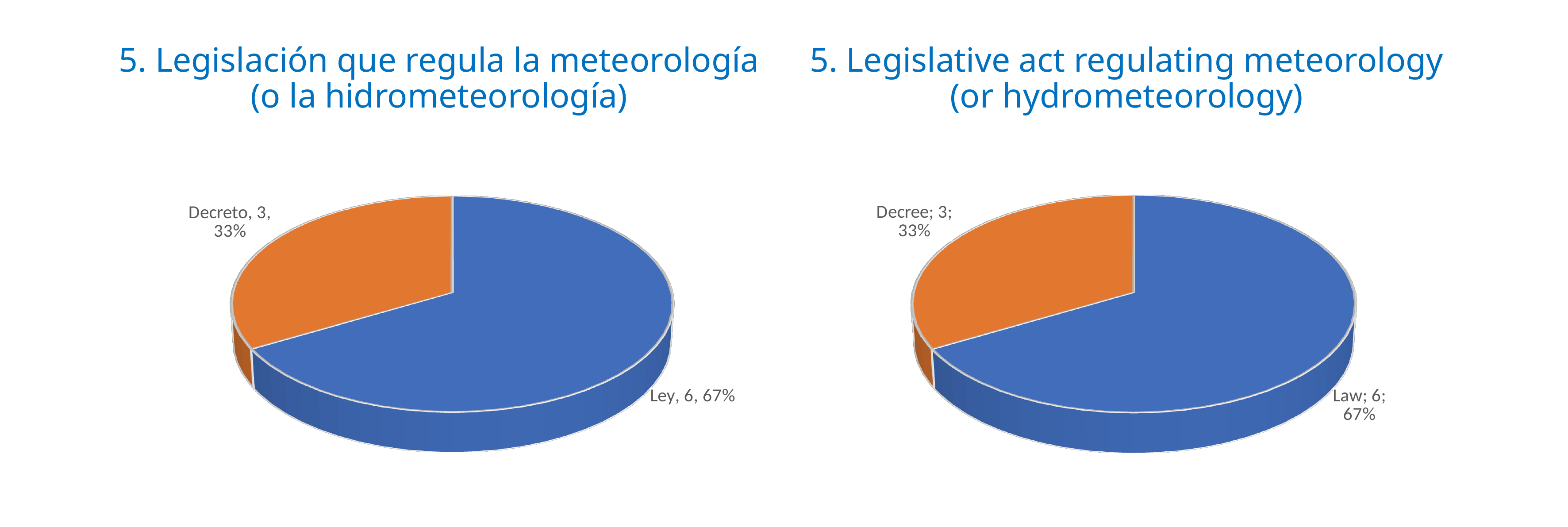
In the left chart titled '5. Legislación que regula la meteorología (o la hidrometeorología)', what share of the pie does Decreto represent? 33% In the right chart titled '5. Legislative act regulating meteorology (or hydrometeorology)', what is the difference between the values for Law and Decree? 3 In the right chart titled '5. Legislative act regulating meteorology (or hydrometeorology)', what is the value for Law? 6 In the right chart titled '5. Legislative act regulating meteorology (or hydrometeorology)', what share of the pie does Law represent? 67% In the right chart titled '5. Legislative act regulating meteorology (or hydrometeorology)', which category is the smallest? Decree How many categories does the right chart titled '5. Legislative act regulating meteorology (or hydrometeorology)' show? 2 In the left chart titled '5. Legislación que regula la meteorología (o la hidrometeorología)', which category is the largest? Ley In the left chart titled '5. Legislación que regula la meteorología (o la hidrometeorología)', which is larger, Ley or Decreto? Ley In the right chart titled '5. Legislative act regulating meteorology (or hydrometeorology)', what is the value for Decree? 3 In the left chart titled '5. Legislación que regula la meteorología (o la hidrometeorología)', what is the value for Ley? 6 In the left chart titled '5. Legislación que regula la meteorología (o la hidrometeorología)', what is the value for Decreto? 3 What kind of chart is the left chart titled '5. Legislación que regula la meteorología (o la hidrometeorología)'? Pie chart